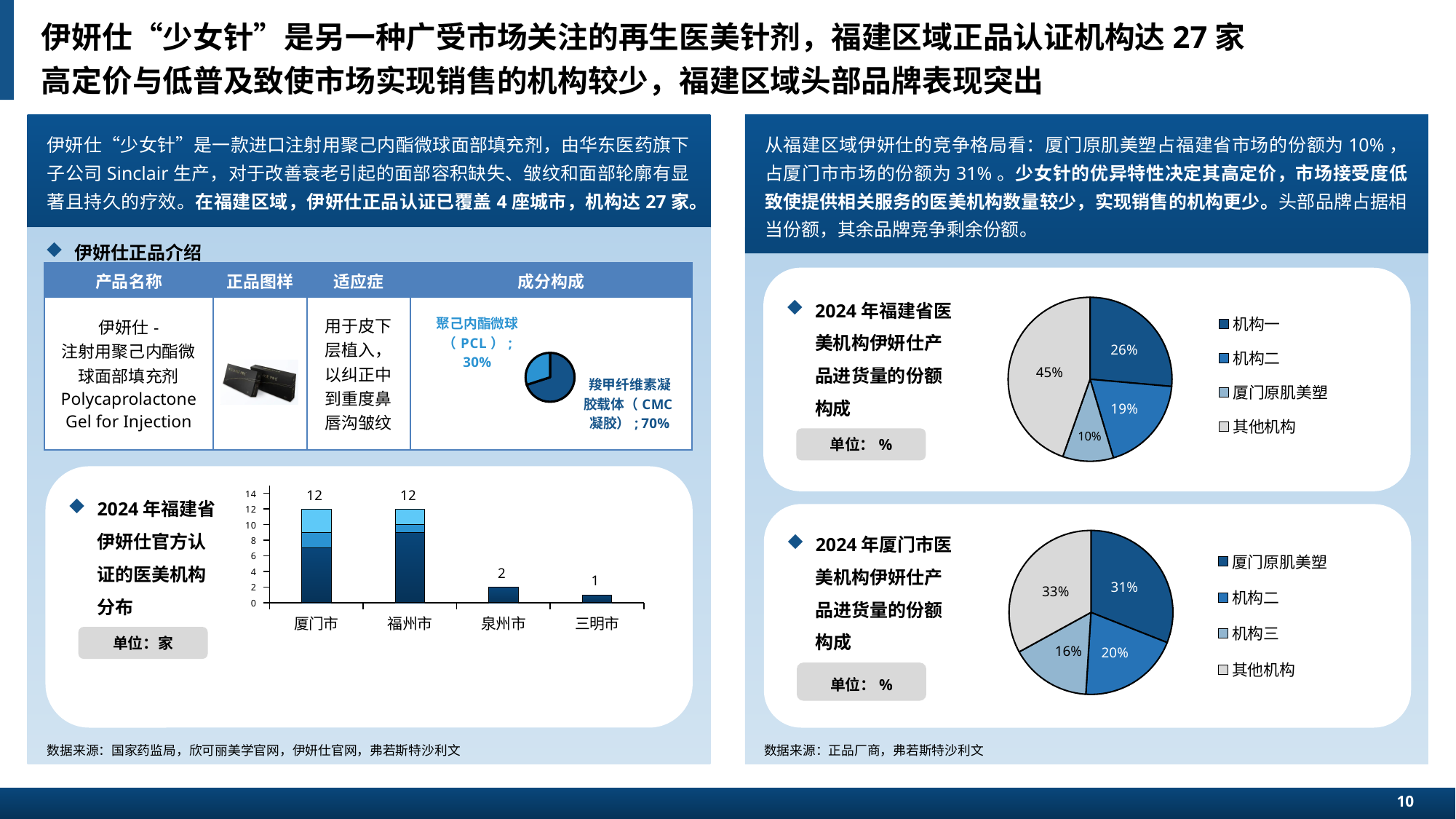
In the pie chart '2024年厦门市医美机构伊妍仕产品进货量的份额构成', which is larger, 机构二 or 机构三? 机构二 In the bar chart '2024年福建省伊妍仕官方认证的医美机构分布', what is the total value for 泉州市? 2 In the bar chart '2024年福建省伊妍仕官方认证的医美机构分布', what is the difference between the totals for 厦门市 and 泉州市? 10 What kind of chart is '2024年福建省伊妍仕官方认证的医美机构分布'? Bar chart In the pie chart '2024年厦门市医美机构伊妍仕产品进货量的份额构成', what share does 厦门原肌美塑 hold? 31% In the pie chart '2024年福建省医美机构伊妍仕产品进货量的份额构成', how many categories does the legend list? 4 In the pie chart '2024年福建省医美机构伊妍仕产品进货量的份额构成', which category has the largest share? 其他机构 What unit is shown for the pie chart '2024年厦门市医美机构伊妍仕产品进货量的份额构成'? % In the bar chart '2024年福建省伊妍仕官方认证的医美机构分布', how many cities are shown on the x axis? 4 In the pie chart '2024年厦门市医美机构伊妍仕产品进货量的份额构成', what is the difference between the shares of 其他机构 and 机构三? 17% In the pie chart '2024年福建省医美机构伊妍仕产品进货量的份额构成', what share does 厦门原肌美塑 hold? 10% In the bar chart '2024年福建省伊妍仕官方认证的医美机构分布', which city has the lowest total? 三明市